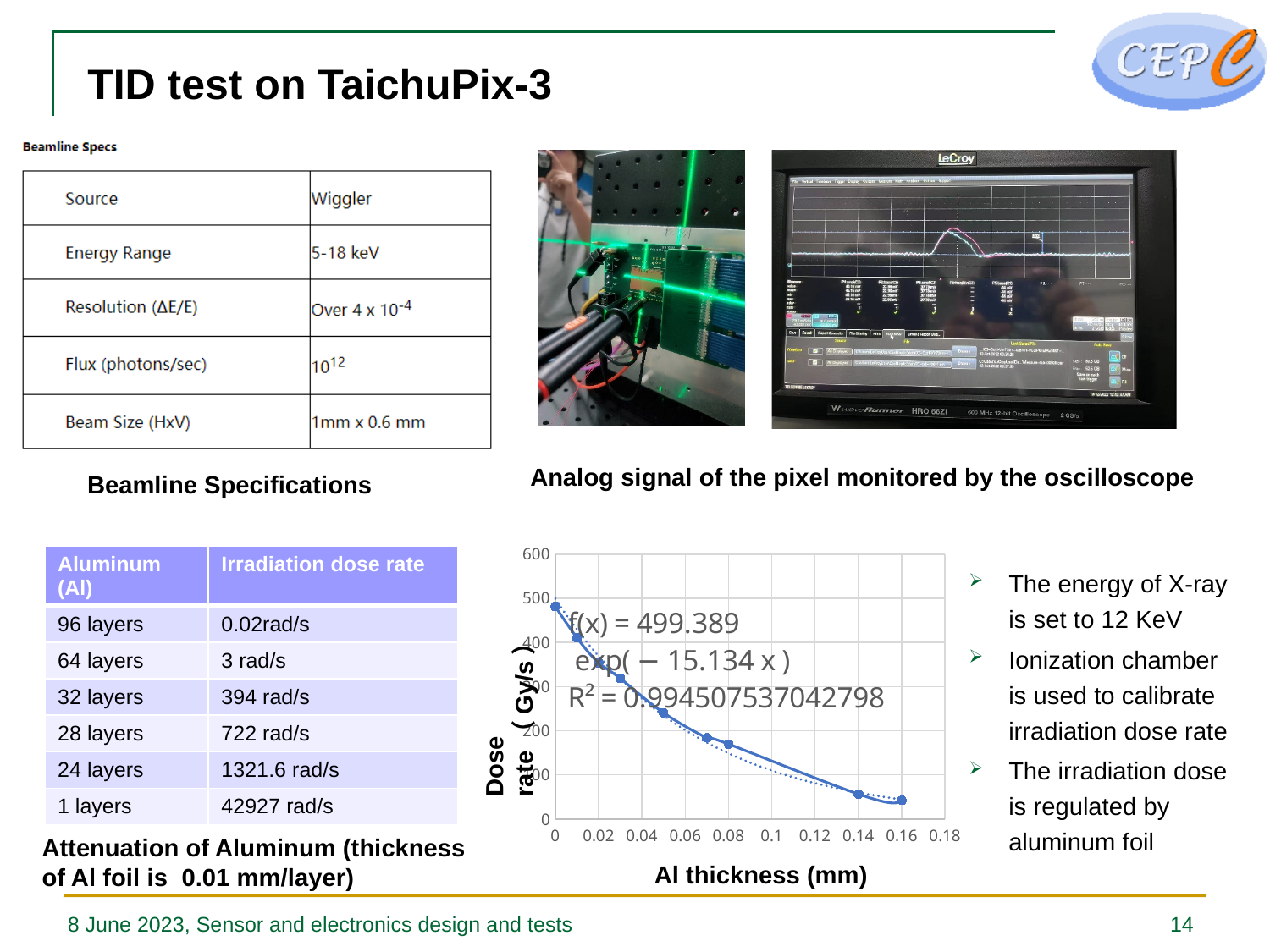
In the dose rate chart, is the dose rate at 0 mm Al thickness greater or less than 400 Gy/s? greater In the dose rate chart, is the dose rate at 0.16 mm Al thickness greater or less than 100 Gy/s? less In the dose rate chart, does the dose rate rise or fall as the Al thickness increases along the x axis? fall In the dose rate chart, is the dose rate at 0.03 mm Al thickness greater or less than 200 Gy/s? greater In the dose rate chart, which has the larger dose rate: 0.02 mm or 0.14 mm Al thickness? 0.02 mm In the dose rate chart, at which Al thickness is the dose rate highest? 0 mm What is the x-axis title of the dose rate chart? Al thickness (mm) What is the R² value shown for the fitted trendline in the dose rate chart? 0.994507537042798 In the dose rate chart, which has the larger dose rate: 0.16 mm or 0.05 mm Al thickness? 0.05 mm